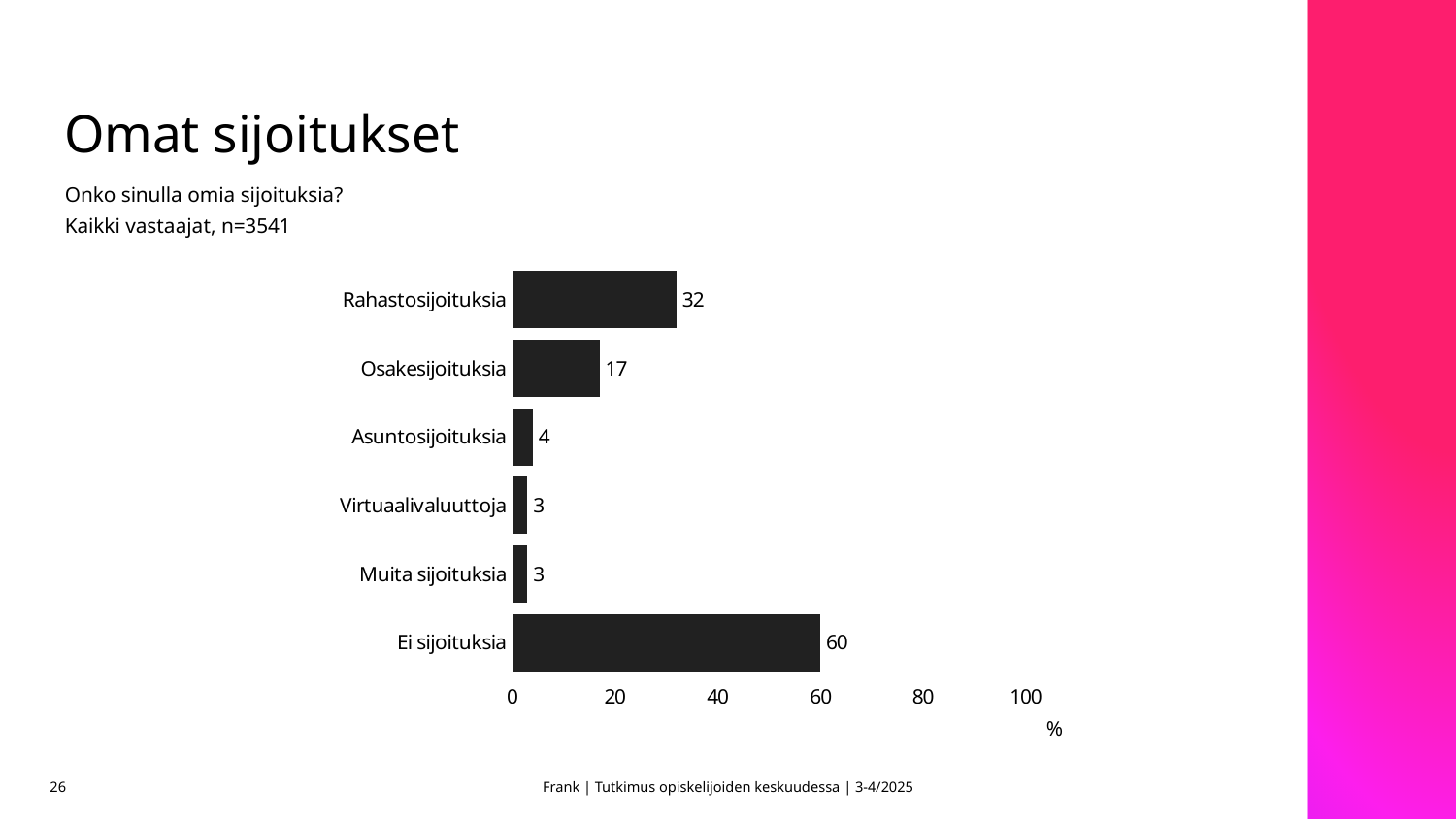
What is the sample size (n) stated on the slide? n=3541 Which is larger, the value for Osakesijoituksia or the value for Asuntosijoituksia? Osakesijoituksia Is the value for Ei sijoituksia greater or less than 40? greater What is the value for Asuntosijoituksia? 4 Which category has the highest value? Ei sijoituksia What is the value for Rahastosijoituksia? 32 What is the difference between the values for Ei sijoituksia and Rahastosijoituksia? 28 What is the value for Osakesijoituksia? 17 How many categories are shown in the chart? 6 What is the difference between the values for Rahastosijoituksia and Osakesijoituksia? 15 What kind of chart is shown on the slide? bar chart What is the value for Ei sijoituksia? 60